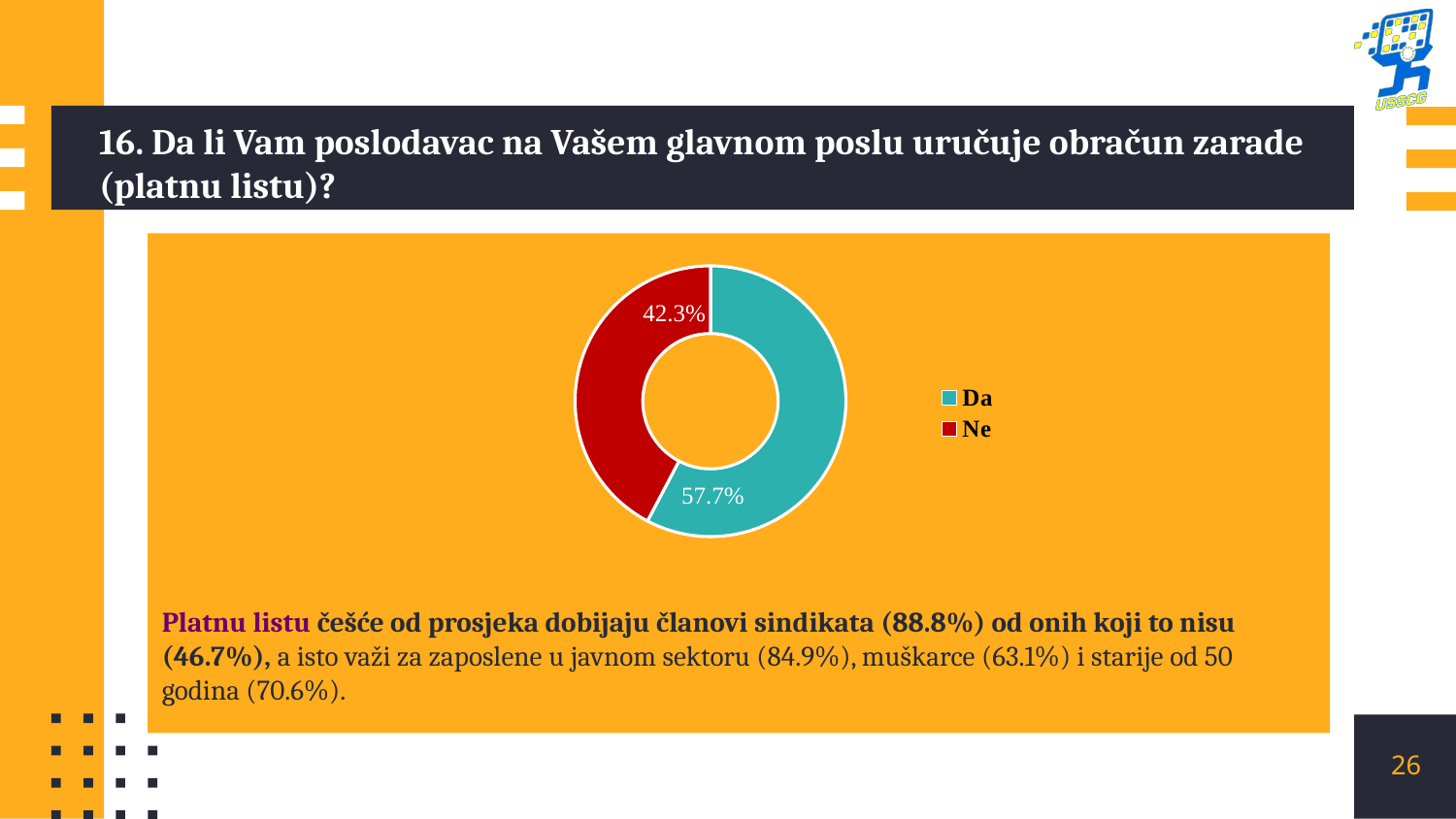
What colour represents the "Da" category in the chart? Teal What percentage of respondents answered "Ne"? 42.3% What colour represents the "Ne" category in the chart? Red Which category has the smallest share of the chart? Ne What percentage of respondents answered "Da"? 57.7% Which category has the largest share of the chart? Da What is the difference in percentage points between the "Da" and "Ne" shares? 15.4 Which is larger, the share for "Da" or the share for "Ne"? Da How many categories are shown in the chart? 2 How many entries does the legend list? 2 What kind of chart is shown on the slide? Doughnut (pie) chart